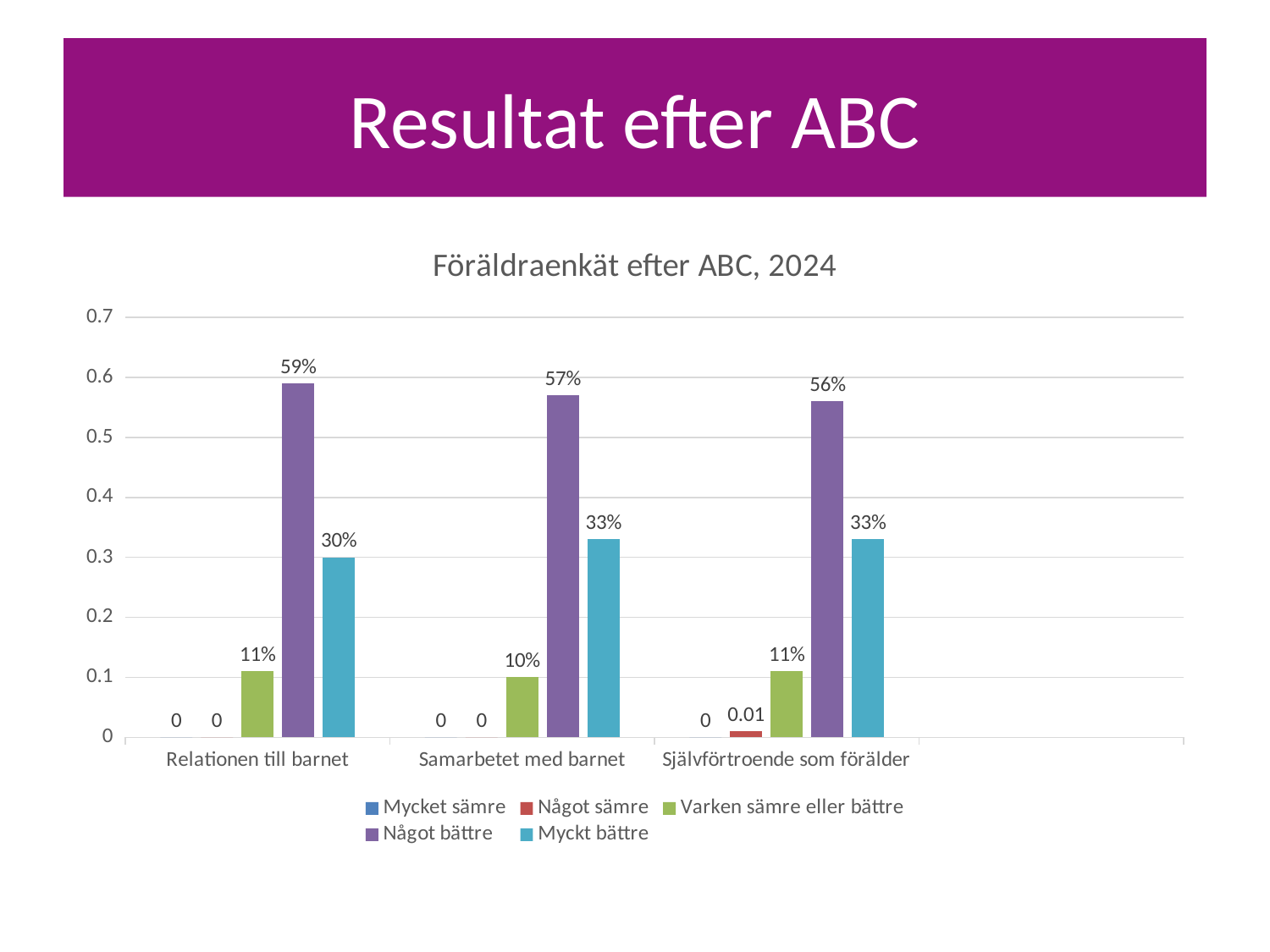
Is the "Varken sämre eller bättre" value for "Samarbetet med barnet" larger or smaller than the same series' value for "Relationen till barnet"? smaller What is the title of the chart? Föräldraenkät efter ABC, 2024 How many categories are shown on the x axis? 3 What is the value for "Något bättre" in the "Relationen till barnet" category? 59% Which category has the highest value for "Något bättre"? Relationen till barnet Which category has the lowest value for "Myckt bättre"? Relationen till barnet How many series does the legend list? 5 What is the value for "Något sämre" in the "Självförtroende som förälder" category? 0.01 What is the value for "Varken sämre eller bättre" in the "Självförtroende som förälder" category? 11% What kind of chart is shown on the slide? bar chart What is the difference between the "Något bättre" and "Myckt bättre" values in the "Relationen till barnet" category? 29% What is the value for "Myckt bättre" in the "Samarbetet med barnet" category? 33%